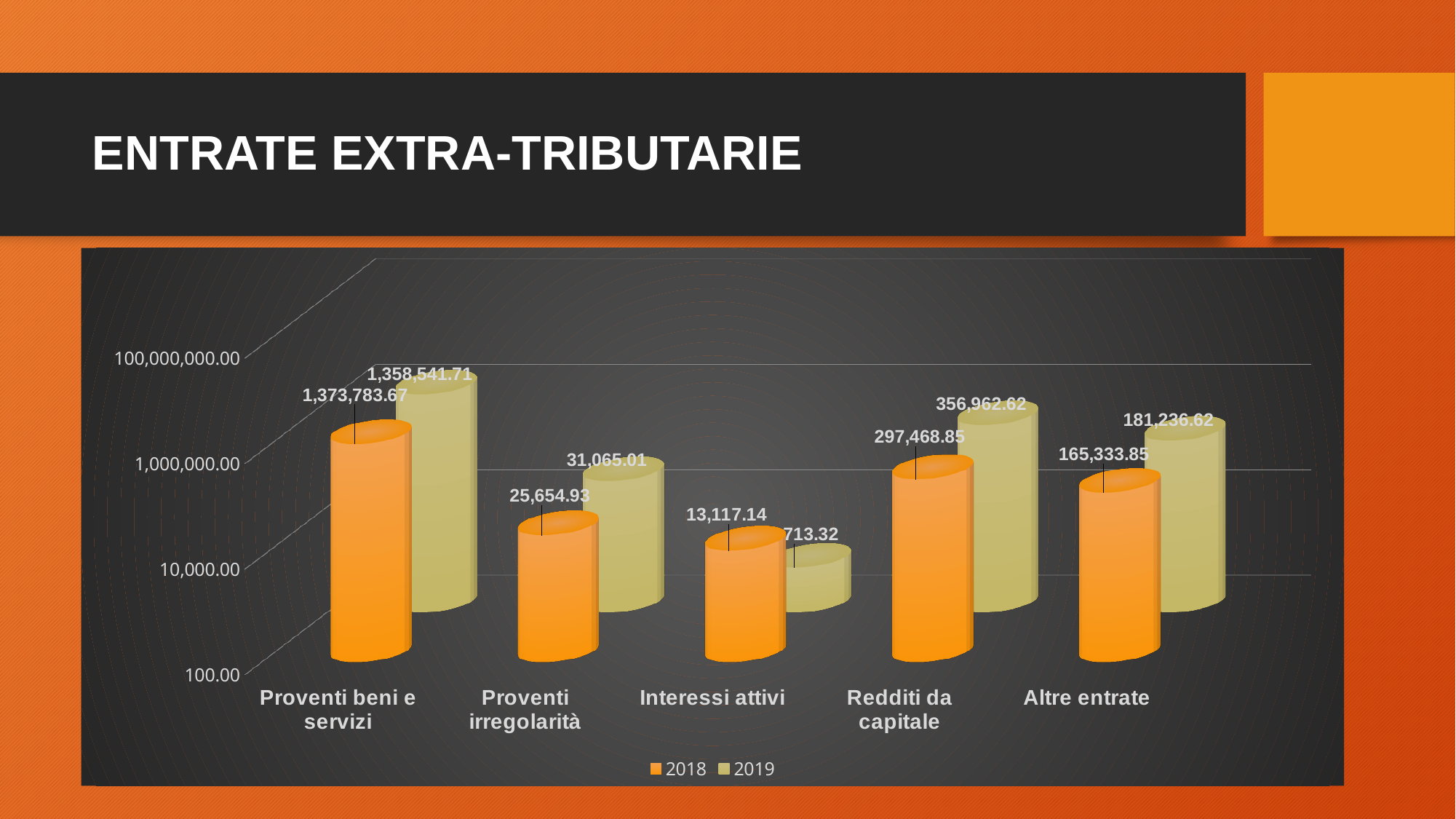
What kind of chart is shown on the slide? Bar chart Which category has the highest 2018 value? Proventi beni e servizi What is the 2018 value for Altre entrate? 165,333.85 What is the 2018 value for Proventi beni e servizi? 1,373,783.67 What is the 2019 value for Proventi irregolarità? 31,065.01 For Proventi beni e servizi, which year has the larger value, 2018 or 2019? 2018 What is the 2019 value for Redditi da capitale? 356,962.62 How many categories are shown on the x axis? 5 What is the difference between the 2019 and 2018 values for Redditi da capitale? 59,493.77 What is the difference between the 2019 and 2018 values for Altre entrate? 15,902.77 Which category has the lowest 2018 value? Interessi attivi How many series does the legend list? 2